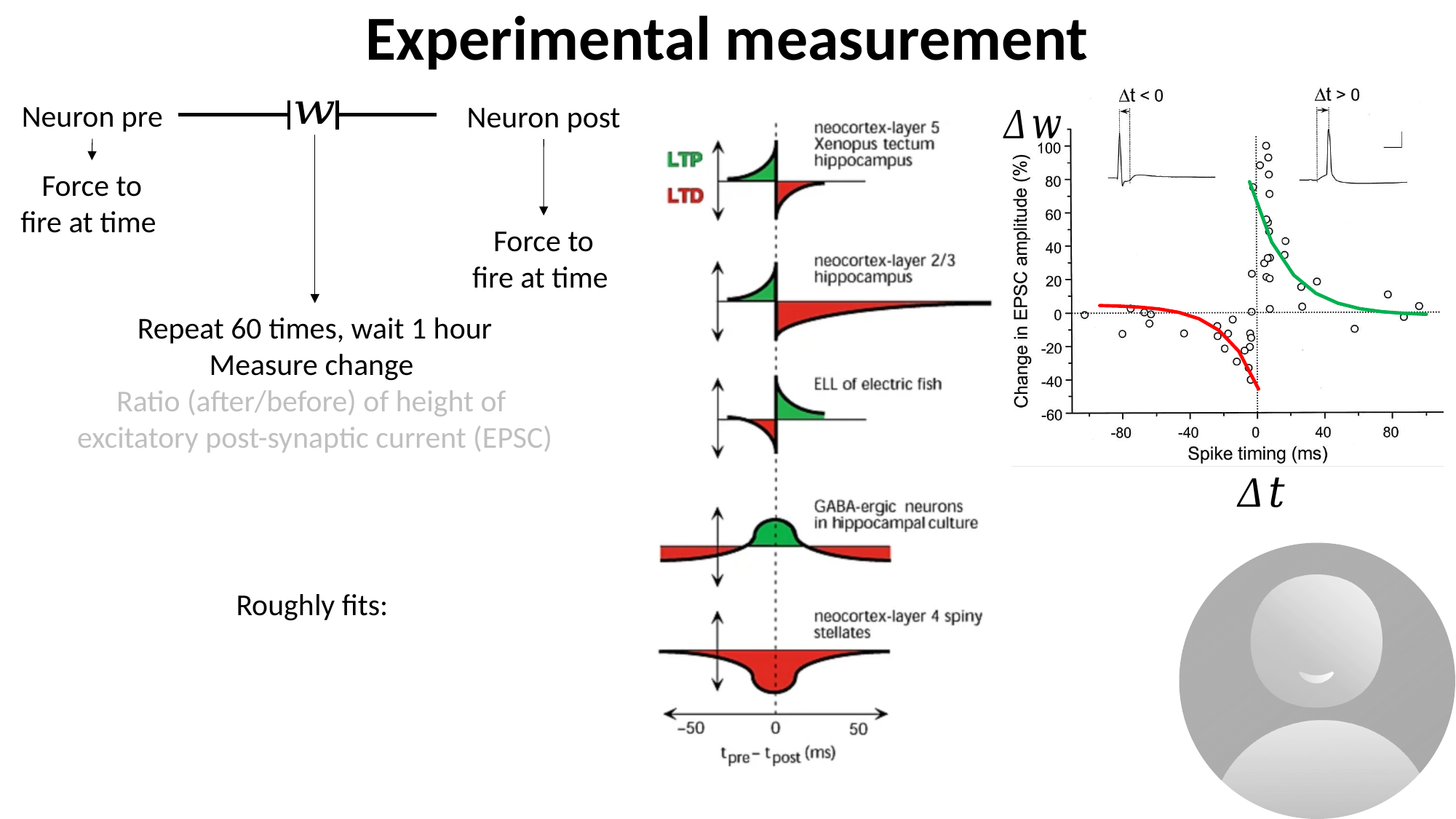
In the chart on the right, what is the largest tick value shown on the y axis? 100 In the chart on the right, for positive spike timing, does the change in EPSC amplitude rise or fall as spike timing increases? fall In the chart on the right, what is the label of the x axis? Spike timing (ms) In the chart on the right, is the highest data point's change in EPSC amplitude greater or less than 80? greater In the middle figure, what is the largest tick value shown on the x axis (t_pre - t_post)? 50 How many schematic panels are stacked in the middle figure (LTP/LTD windows)? 5 In the middle figure, which panel shows only depression (red) and no potentiation (green)? neocortex-layer 4 spiny stellates In the chart on the right, is the lowest data point's change in EPSC amplitude greater or less than -20? less In the chart on the right, what is the label of the y axis? Change in EPSC amplitude (%) What kind of chart is the chart on the right of the slide (Change in EPSC amplitude vs Spike timing)? scatter plot In the chart on the right, what is the smallest tick value shown on the y axis? -60 In the chart on the right, for negative spike timing, does the red fitted curve rise or fall as spike timing increases toward 0? fall